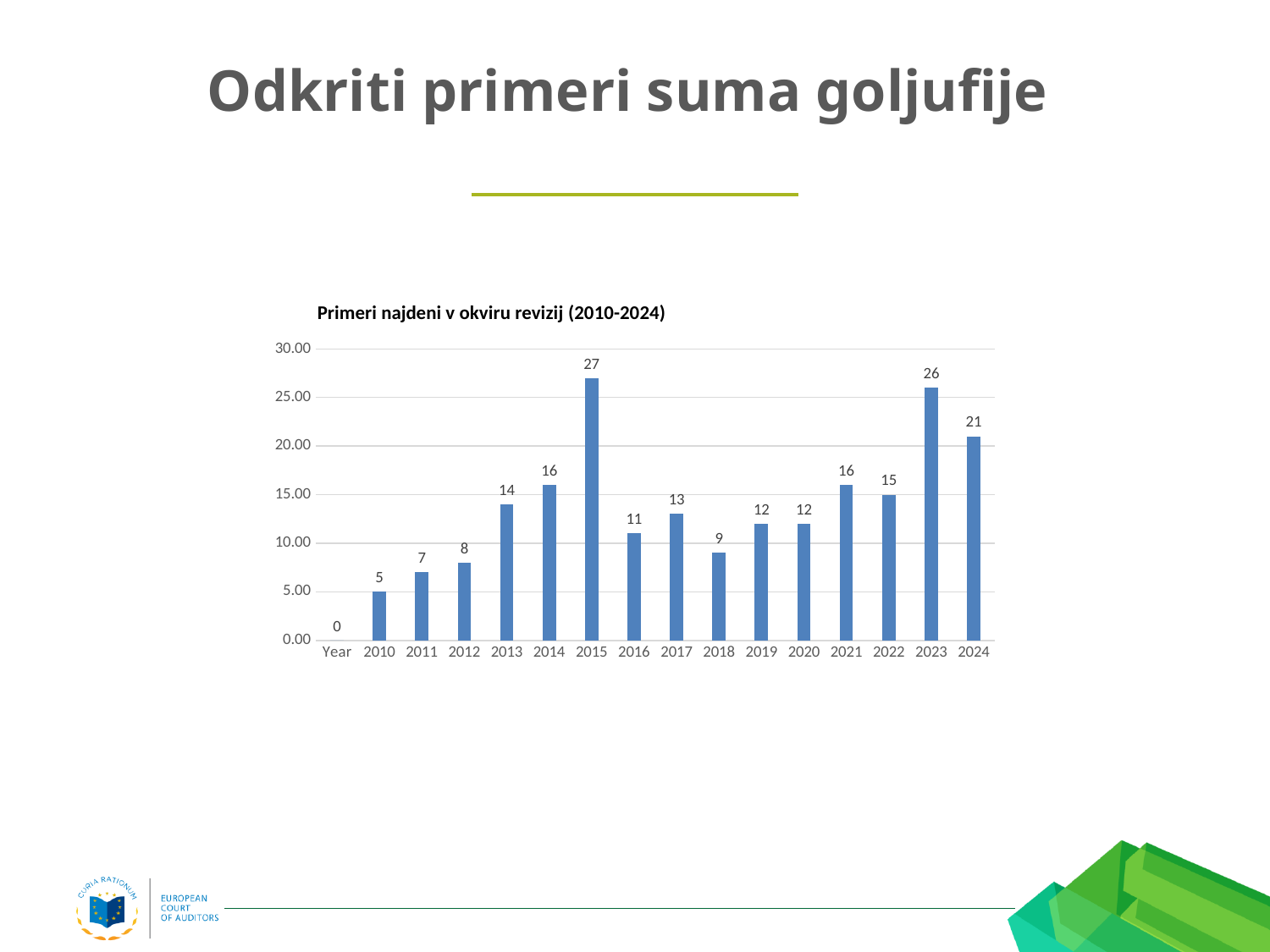
What is the value for 2023 in the chart? 26 What is the difference between the values for 2015 and 2023? 1 Which is larger, the value for 2021 or the value for 2022? 2021 Which is larger, the value for 2014 or the value for 2016? 2014 What is the title of the chart? Primeri najdeni v okviru revizij (2010-2024) What kind of chart is shown on the slide? bar chart What is the value for 2018 in the chart? 9 What is the value for 2010 in the chart? 5 What is the difference between the values for 2024 and 2010? 16 Do the values rise or fall from 2010 to 2015? rise Which year has the highest value in the chart? 2015 What is the value for 2015 in the chart? 27